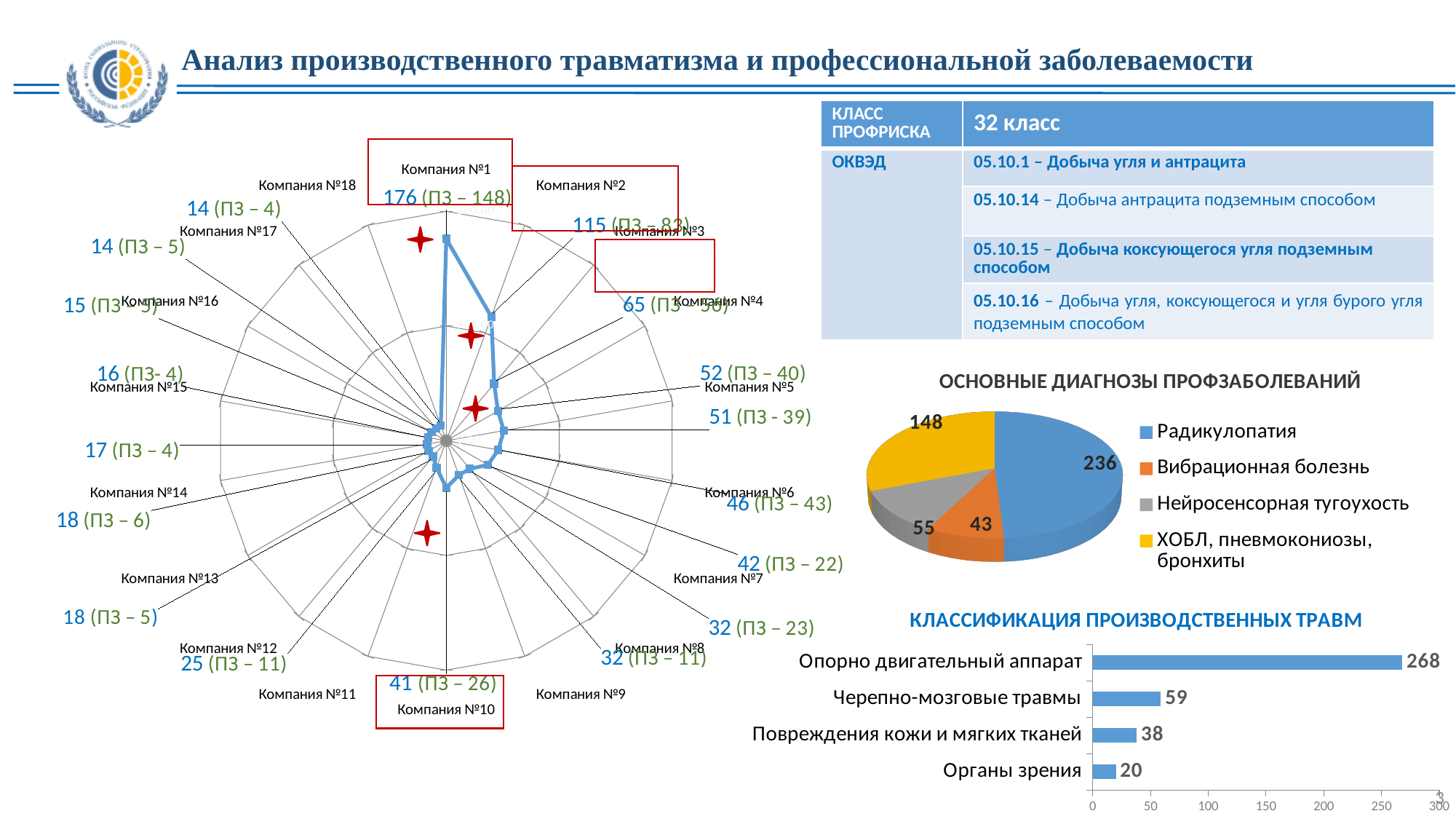
On the bar chart 'КЛАССИФИКАЦИЯ ПРОИЗВОДСТВЕННЫХ ТРАВМ', how many categories are shown? 4 On the radar chart on the left, which company has the highest value? Компания №1 On the bar chart 'КЛАССИФИКАЦИЯ ПРОИЗВОДСТВЕННЫХ ТРАВМ', what is the difference between 'Опорно двигательный аппарат' and 'Черепно-мозговые травмы'? 209 On the bar chart 'КЛАССИФИКАЦИЯ ПРОИЗВОДСТВЕННЫХ ТРАВМ', which category has the lowest value? Органы зрения On the pie chart 'ОСНОВНЫЕ ДИАГНОЗЫ ПРОФЗАБОЛЕВАНИЙ', which is larger: 'Вибрационная болезнь' or 'ХОБЛ, пневмокониозы, бронхиты'? ХОБЛ, пневмокониозы, бронхиты On the bar chart 'КЛАССИФИКАЦИЯ ПРОИЗВОДСТВЕННЫХ ТРАВМ', what is the value for 'Органы зрения'? 20 On the pie chart 'ОСНОВНЫЕ ДИАГНОЗЫ ПРОФЗАБОЛЕВАНИЙ', how many entries does the legend list? 4 On the pie chart 'ОСНОВНЫЕ ДИАГНОЗЫ ПРОФЗАБОЛЕВАНИЙ', what is the value for 'Нейросенсорная тугоухость'? 55 What kind of chart is 'КЛАССИФИКАЦИЯ ПРОИЗВОДСТВЕННЫХ ТРАВМ'? bar chart On the pie chart 'ОСНОВНЫЕ ДИАГНОЗЫ ПРОФЗАБОЛЕВАНИЙ', what is the value for 'Радикулопатия'? 236 On the bar chart 'КЛАССИФИКАЦИЯ ПРОИЗВОДСТВЕННЫХ ТРАВМ', what is the value for 'Опорно двигательный аппарат'? 268 On the radar chart on the left, what value is printed for Компания №10? 41 (ПЗ – 26)